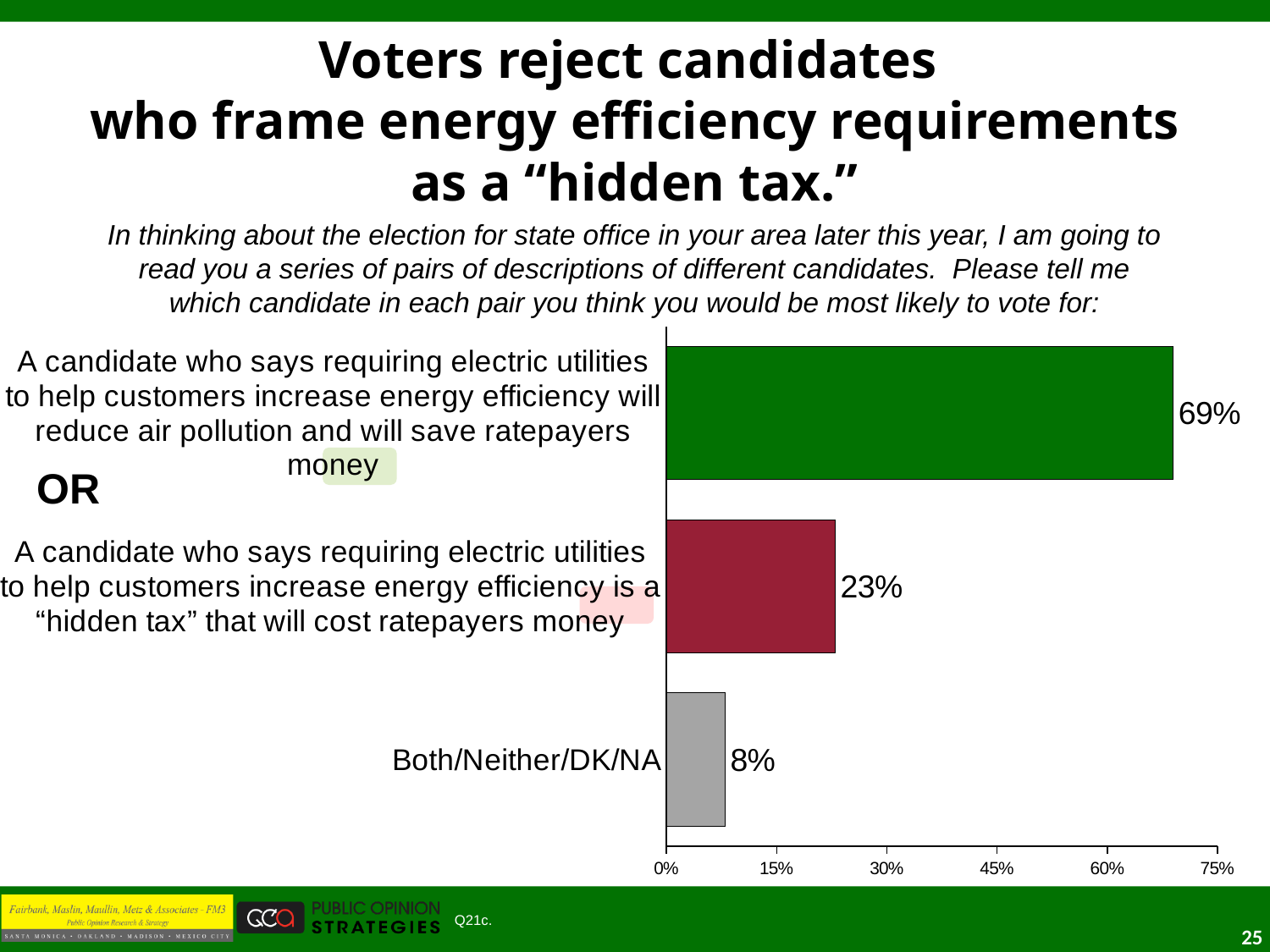
What percentage of voters chose the candidate who says requiring electric utilities to help customers increase energy efficiency will reduce air pollution and save ratepayers money? 69% What colour is the bar for the "hidden tax" candidate? Red Which response received the highest percentage? A candidate who says requiring electric utilities to help customers increase energy efficiency will reduce air pollution and will save ratepayers money Is the value for the "hidden tax" candidate greater or less than 30%? less Which is larger: the percentage for the "hidden tax" candidate or the percentage for Both/Neither/DK/NA? The "hidden tax" candidate What percentage of respondents answered Both/Neither/DK/NA? 8% What type of chart is shown on the slide? Bar chart What percentage of voters chose the candidate who says requiring electric utilities to help customers increase energy efficiency is a "hidden tax"? 23% What is the difference in percentage points between the "hidden tax" candidate and Both/Neither/DK/NA? 15 Which response received the lowest percentage? Both/Neither/DK/NA What is the difference in percentage points between the "reduce air pollution and save ratepayers money" candidate and the "hidden tax" candidate? 46 How many response categories are shown in the chart? 3